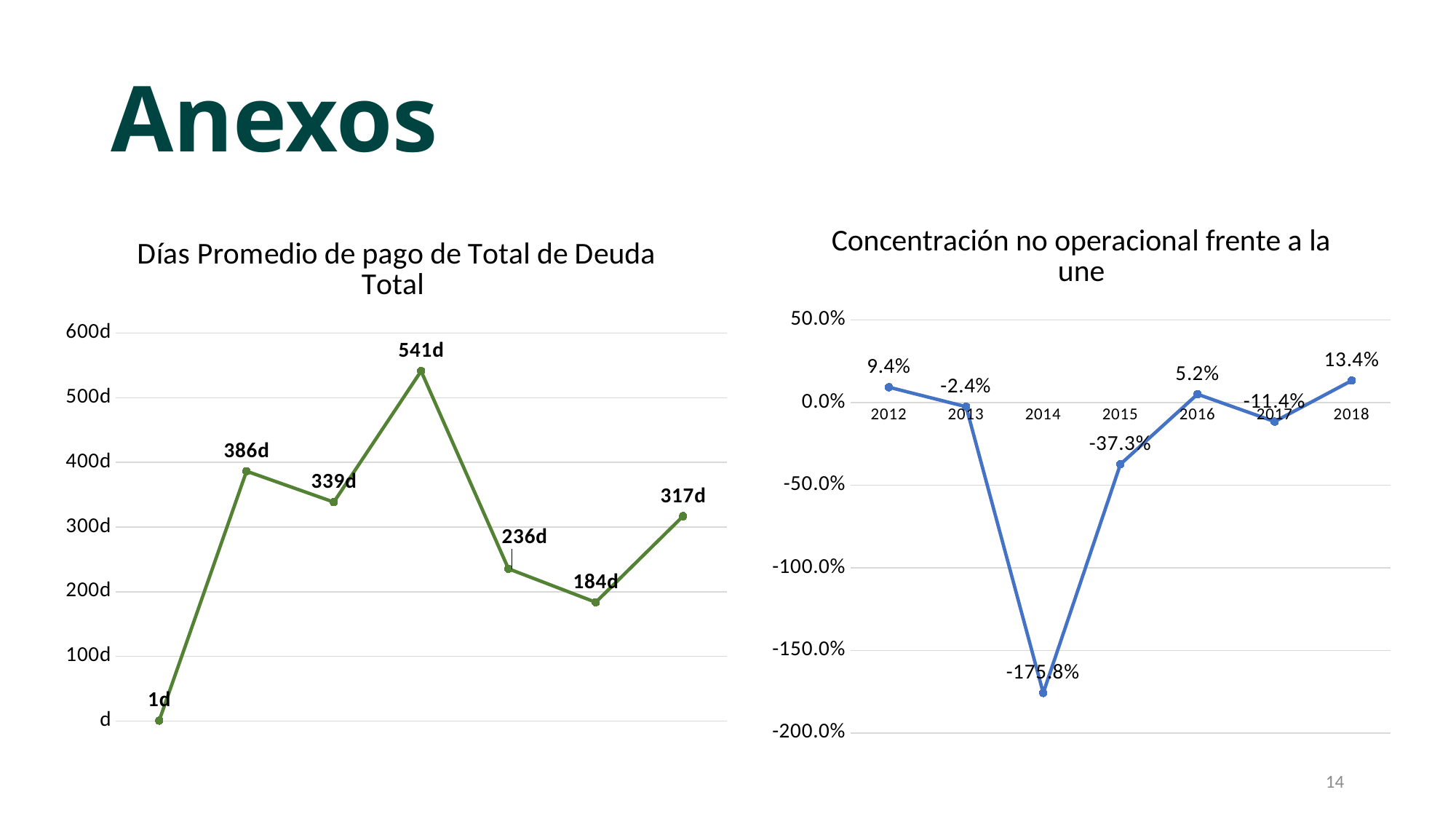
In the chart 'Concentración no operacional frente a la une', which year has the lowest value? 2014 In the chart 'Días Promedio de pago de Total de Deuda Total', what is the lowest value shown? 1d What type of chart is 'Días Promedio de pago de Total de Deuda Total'? Line chart In the chart 'Concentración no operacional frente a la une', what is the value for 2018? 13.4% In the chart 'Concentración no operacional frente a la une', which is larger, the value for 2012 or the value for 2016? 2012 In the chart 'Concentración no operacional frente a la une', which year has the highest value? 2018 In the chart 'Concentración no operacional frente a la une', is the value for 2015 greater or less than -50.0%? greater In the chart 'Días Promedio de pago de Total de Deuda Total', what is the difference between the highest value (541d) and the lowest value (1d)? 540d In the chart 'Concentración no operacional frente a la une', how many years are plotted? 7 In the chart 'Días Promedio de pago de Total de Deuda Total', what is the highest value shown? 541d In the chart 'Días Promedio de pago de Total de Deuda Total', how many data points are plotted? 7 In the chart 'Concentración no operacional frente a la une', what is the value for 2014? -175.8%